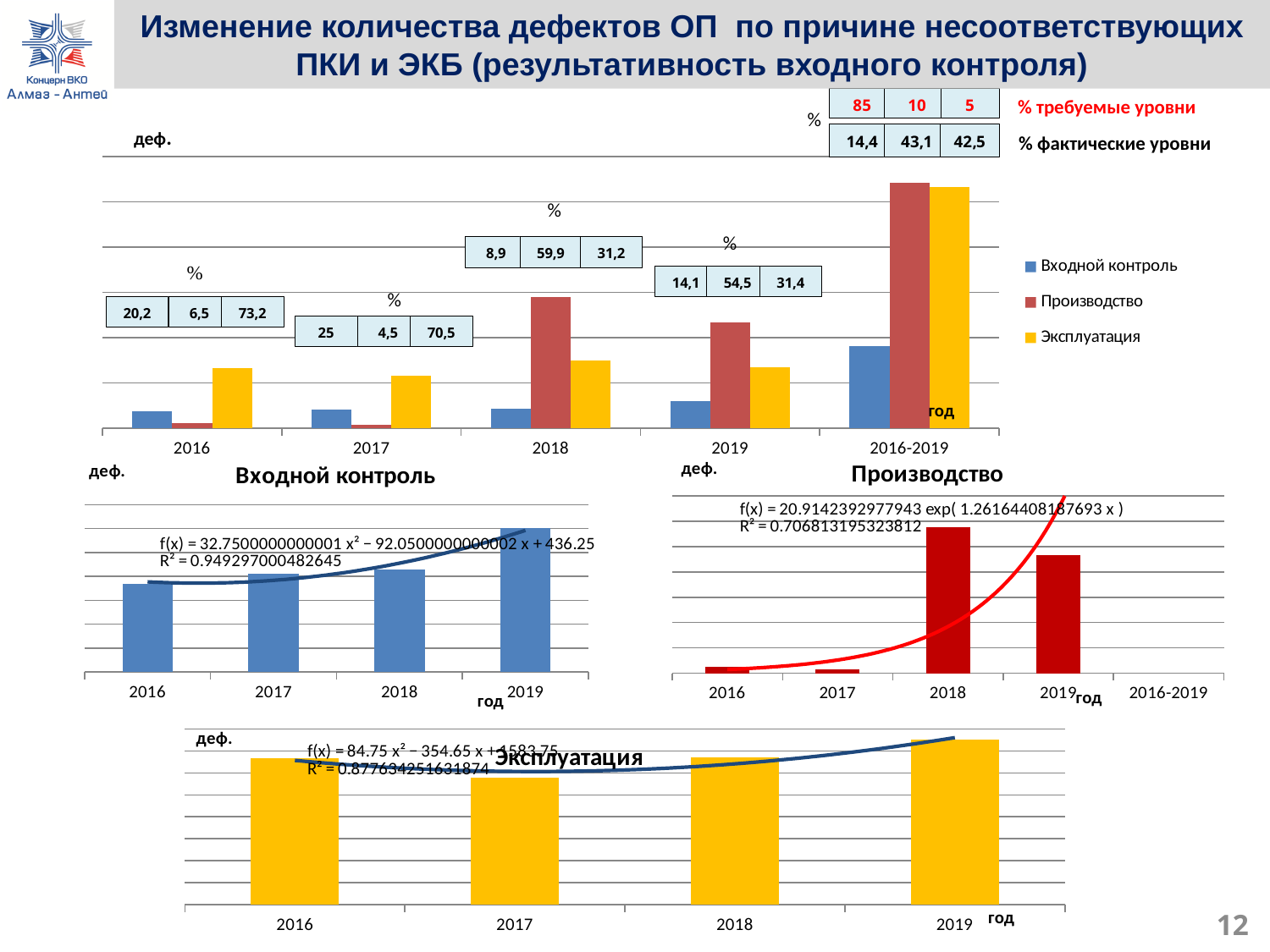
In the top chart, what colour represents the Эксплуатация series? yellow In the 'Входной контроль' chart, do the bar values rise or fall from 2016 to 2019? rise In the top chart, what is the required level (% требуемые уровни) for Входной контроль for 2016-2019? 85 How many series does the legend of the top chart list? 3 In the top chart, what is the actual level (% фактические уровни) for Производство for 2016-2019? 43,1 How many bars are plotted in the 'Входной контроль' chart? 4 What kind of chart is the top chart on the slide? bar chart In the top chart, what is the difference between the 2018 percentages for Производство and Эксплуатация? 28,7 In the top chart, what percentage is shown for Эксплуатация in 2016? 73,2 In the top chart, which series has the tallest bar in 2019? Производство How many categories are shown on the x axis of the top chart? 5 In the top chart, what percentage is shown for Производство in 2018? 59,9